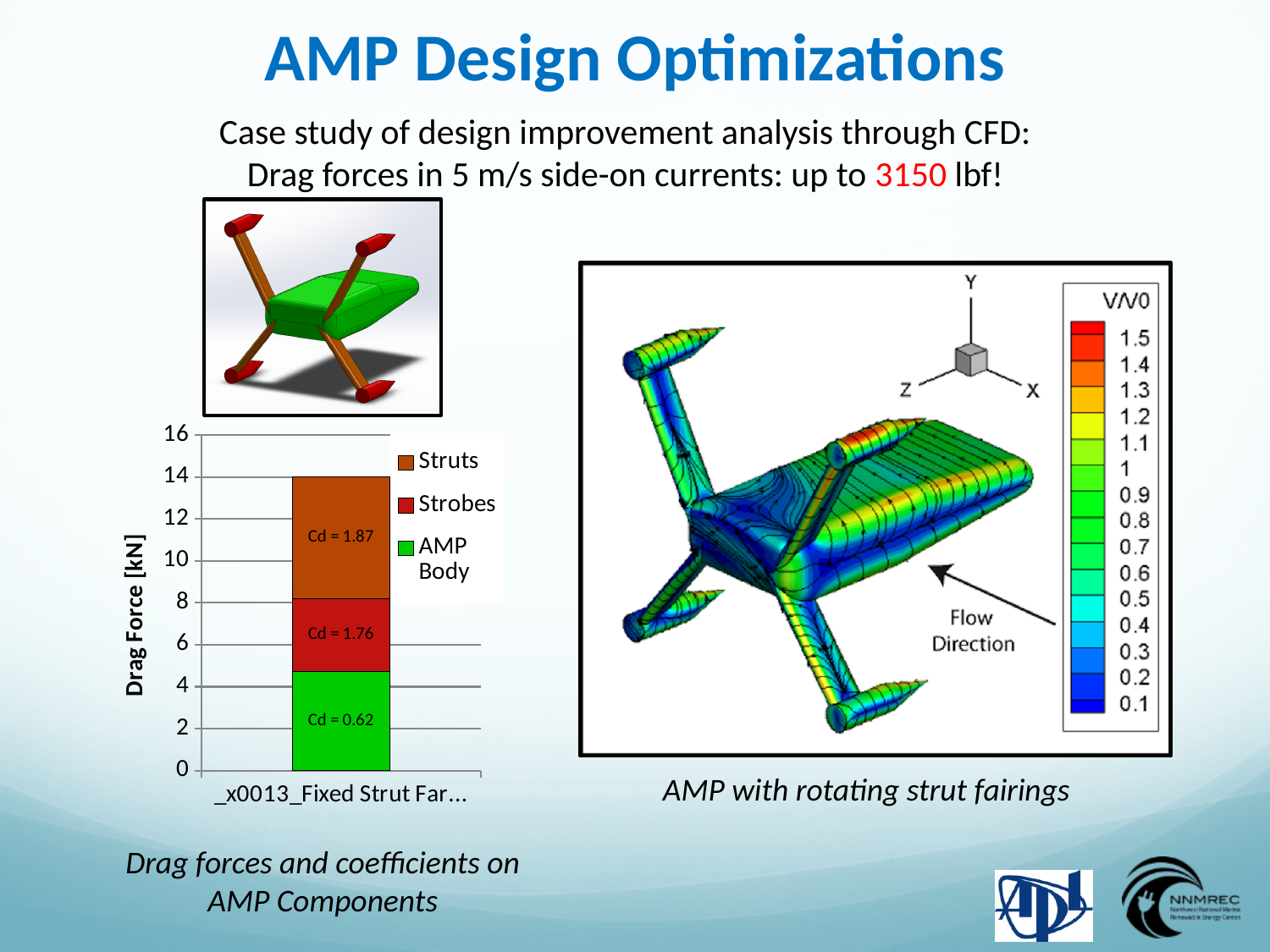
How many bars (categories) are plotted in the drag force chart? 1 Is the total height of the stacked bar greater or less than 12 kN? greater What are the legend entries of the drag force chart? Struts, Strobes, AMP Body What is the drag coefficient label printed on the Strobes segment of the bar? Cd = 1.76 What kind of chart is shown on the left of the slide? Stacked bar chart Is the drag force of the AMP Body segment greater or less than 6 kN? less Which has the larger printed drag coefficient, Struts or Strobes? Struts What is the drag coefficient label printed on the Struts segment of the bar? Cd = 1.87 What is the drag coefficient label printed on the AMP Body segment of the bar? Cd = 0.62 What is the title of the vertical axis of the drag force chart? Drag Force [kN] Which component contributes the largest segment of drag force in the stacked bar? Struts How many series does the legend of the drag force chart list? 3